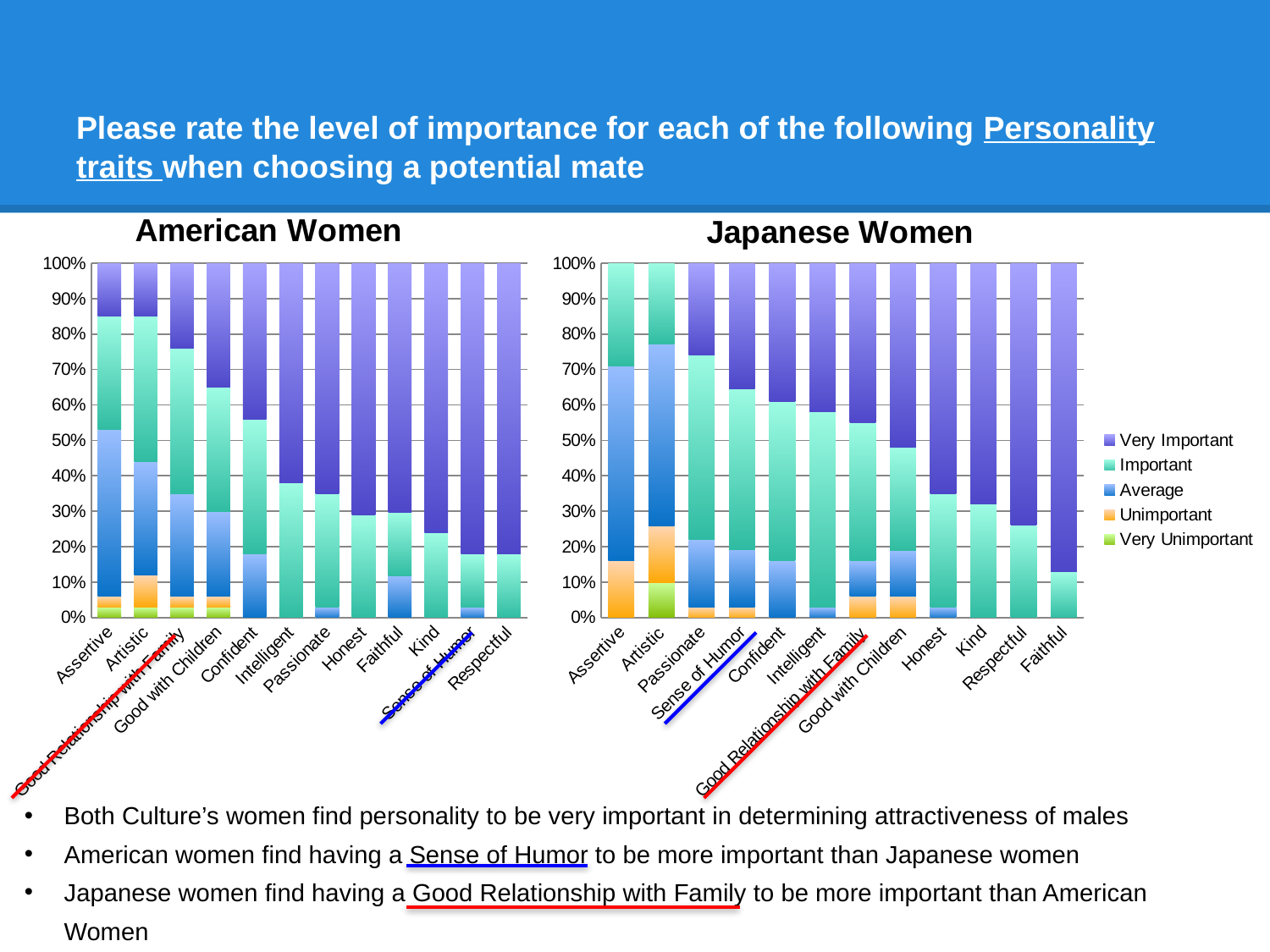
In the Japanese Women chart, is the Very Important share for Faithful greater or less than 80%? greater In the American Women chart, is the Very Important share for Assertive greater or less than 20%? less What kind of chart is the American Women chart? Stacked bar chart In the American Women chart, is the Very Important share for Respectful greater or less than 70%? greater Which colour represents the Very Important series in the legend? Purple In the American Women chart, which has the larger Average share, Assertive or Artistic? Assertive How many personality traits are shown on the Japanese Women chart? 12 How many series does the legend list? 5 In the Japanese Women chart, does the Very Important share generally rise or fall from left to right across the traits? rise In the Japanese Women chart, which trait has the largest Very Important share? Faithful How many personality traits are shown on the American Women chart? 12 In the Japanese Women chart, which has the larger Very Important share, Faithful or Respectful? Faithful